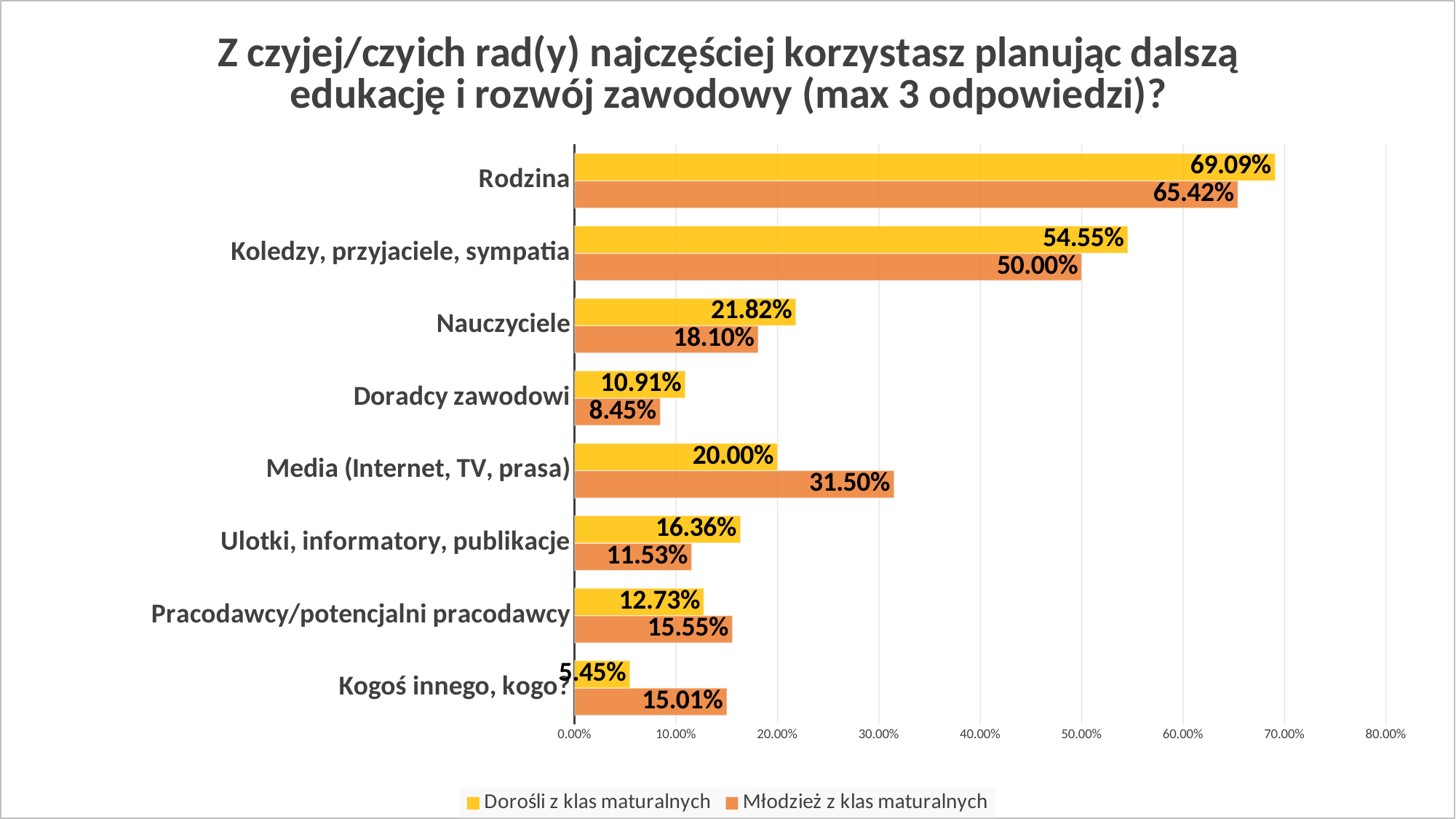
How many categories are shown on the chart? 8 What is the value for Media (Internet, TV, prasa) in the Młodzież z klas maturalnych series? 31.50% What is the value for Rodzina in the Dorośli z klas maturalnych series? 69.09% Which category has the highest value in the Młodzież z klas maturalnych series? Rodzina Which category has the lowest value in the Dorośli z klas maturalnych series? Kogoś innego, kogo? What kind of chart is shown on the slide? Bar chart Which colour represents the Młodzież z klas maturalnych series? Orange What is the value for Kogoś innego, kogo? in the Młodzież z klas maturalnych series? 15.01% Is the value for Koledzy, przyjaciele, sympatia in the Dorośli z klas maturalnych series greater or less than 50.00%? greater For Pracodawcy/potencjalni pracodawcy, which series has the larger value? Młodzież z klas maturalnych What is the difference between the Dorośli z klas maturalnych and Młodzież z klas maturalnych values for Nauczyciele? 3.72% How many series does the legend list? 2